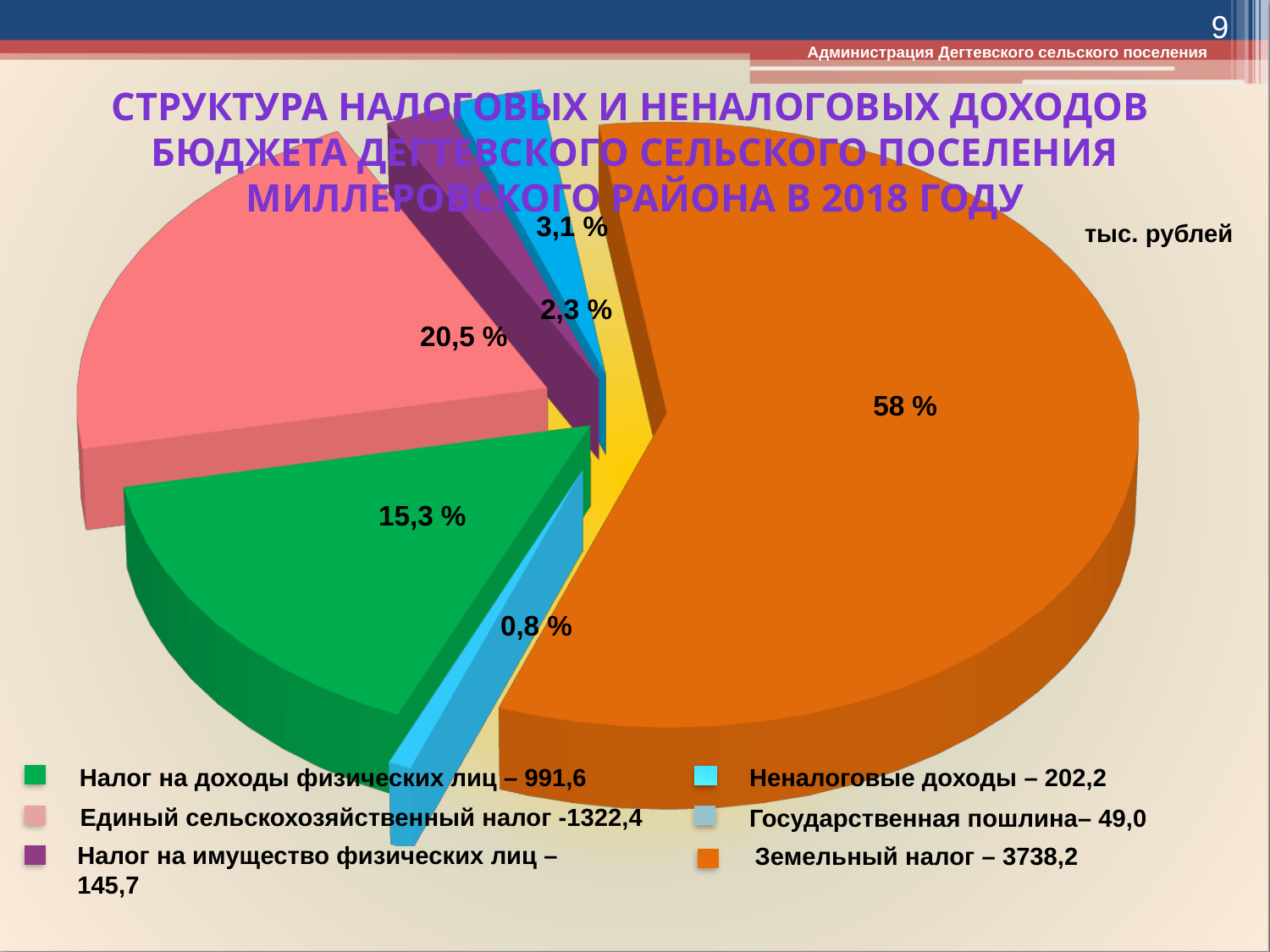
Which category has the smallest slice of the pie? Государственная пошлина What is the value for Земельный налог according to the legend? 3738,2 What kind of chart is shown on the slide? pie chart How many slices does the pie chart have? 6 What unit is indicated for the values on the chart? тыс. рублей What share of the pie does Налог на имущество физических лиц take? 2,3 % What share of the pie does Единый сельскохозяйственный налог take? 20,5 % What share of the pie does Земельный налог take? 58 % What is the value for Неналоговые доходы according to the legend? 202,2 Which is larger, Налог на доходы физических лиц or Единый сельскохозяйственный налог? Единый сельскохозяйственный налог Which category has the largest slice of the pie? Земельный налог